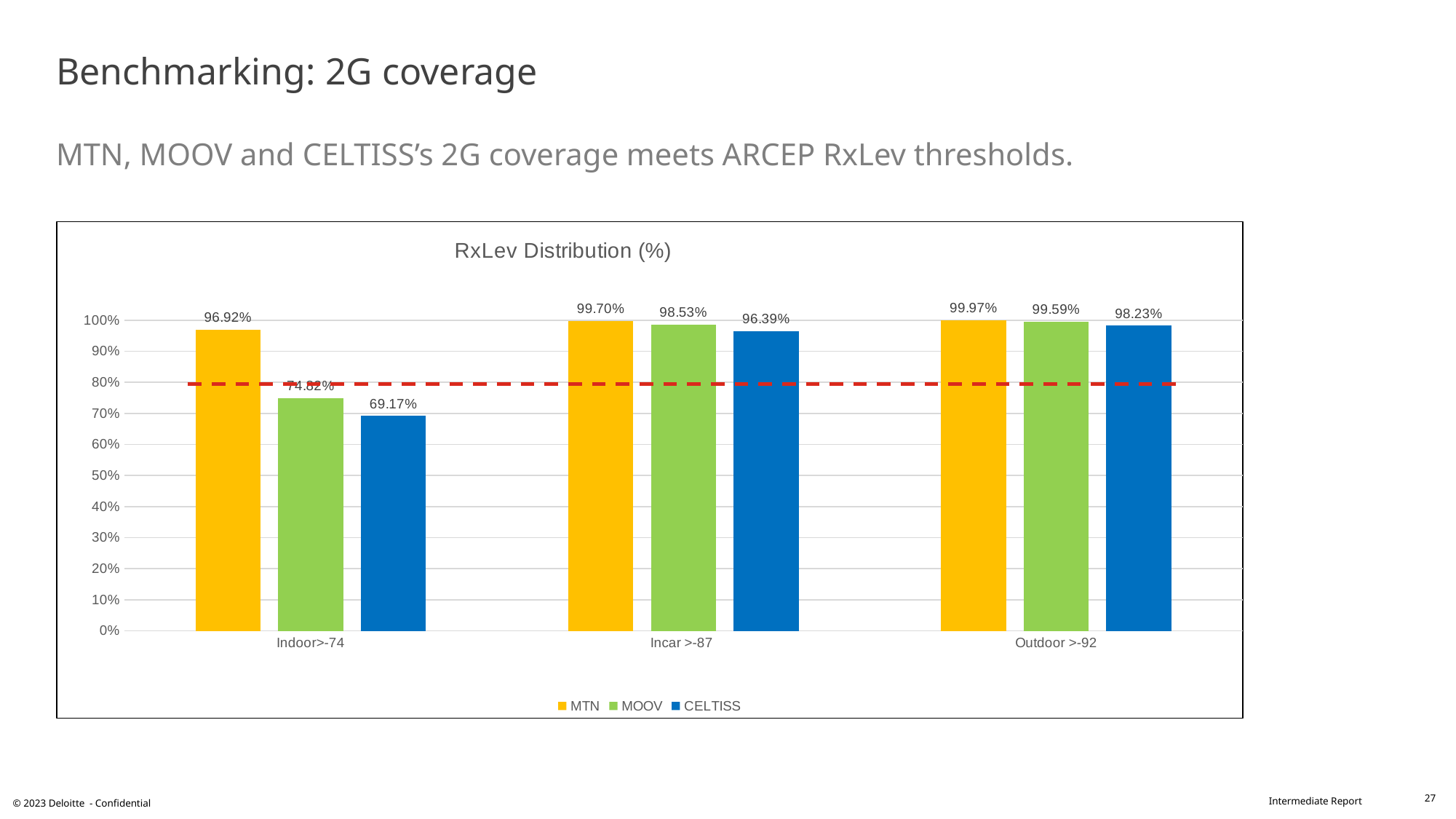
How many series does the legend list? 3 Which is larger: the MOOV value for Incar >-87 or the MOOV value for Outdoor >-92? Outdoor >-92 What is the value for MTN in the Outdoor >-92 category? 99.97% Which operator has the lowest value in the Indoor>-74 category? CELTISS What is the difference between the MTN and CELTISS values in the Indoor>-74 category? 27.75 percentage points What is the value for CELTISS in the Outdoor >-92 category? 98.23% What is the title of the chart? RxLev Distribution (%) Which operator has the highest value in the Incar >-87 category? MTN Is the value for CELTISS in the Indoor>-74 category greater or less than 80%? less What is the value for CELTISS in the Indoor>-74 category? 69.17% What is the value for MOOV in the Incar >-87 category? 98.53% What is the value for MTN in the Indoor>-74 category? 96.92%